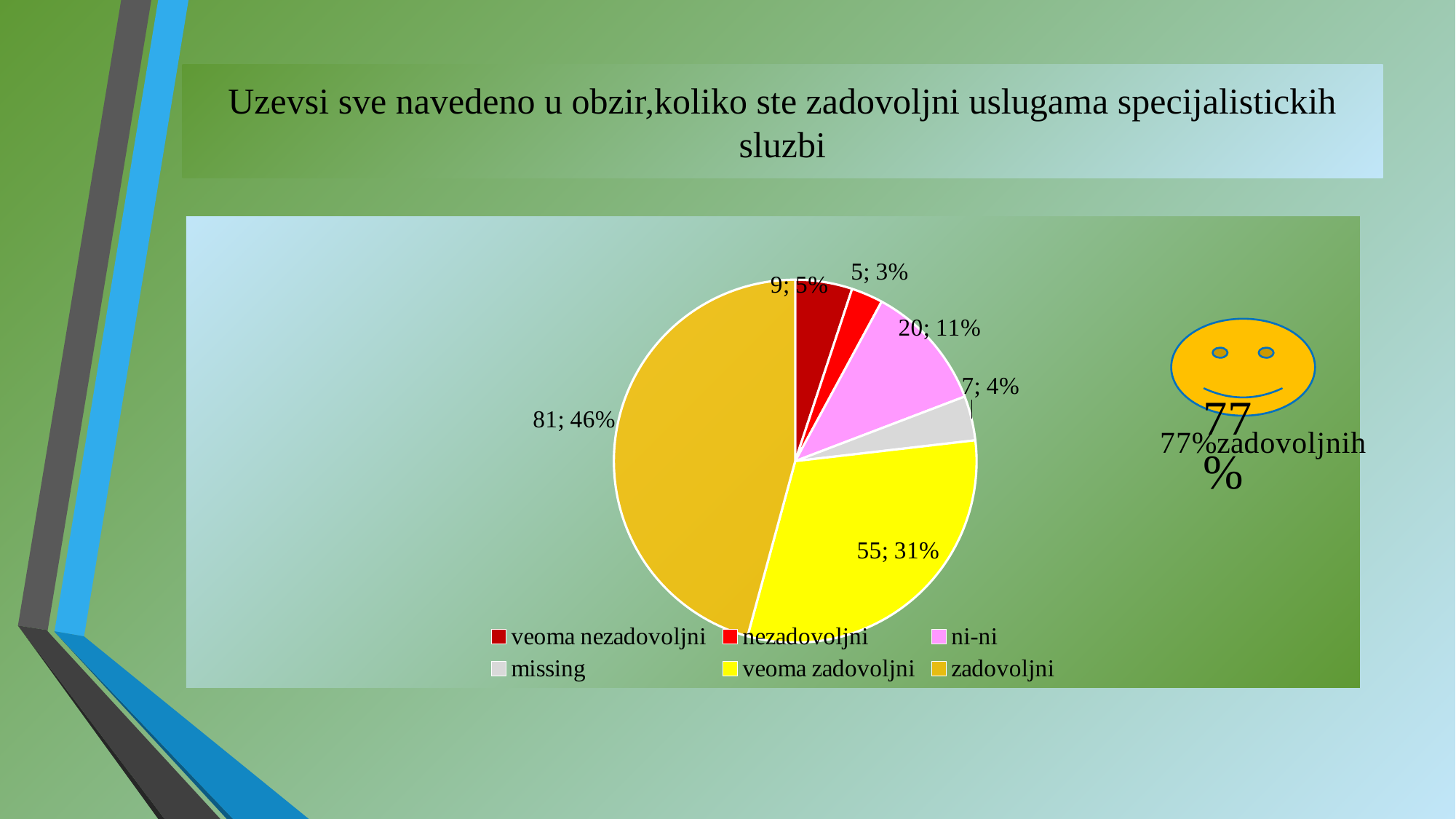
Which is larger, the 'ni-ni' slice or the 'missing' slice? ni-ni What kind of chart is shown on the slide? pie chart Which category has the largest slice of the pie? zadovoljni How many slices does the pie chart have? 6 What is the count and share for the 'zadovoljni' slice? 81; 46% What share of the pie does the 'veoma nezadovoljni' slice represent? 5% What is the difference in count between 'zadovoljni' and 'veoma zadovoljni'? 26 What is the count and share for the 'nezadovoljni' slice? 5; 3% Which category has the smallest slice of the pie? nezadovoljni What is the count and share for the 'veoma zadovoljni' slice? 55; 31% What colour is the 'veoma zadovoljni' slice? yellow What is the count and share for the 'ni-ni' slice? 20; 11%